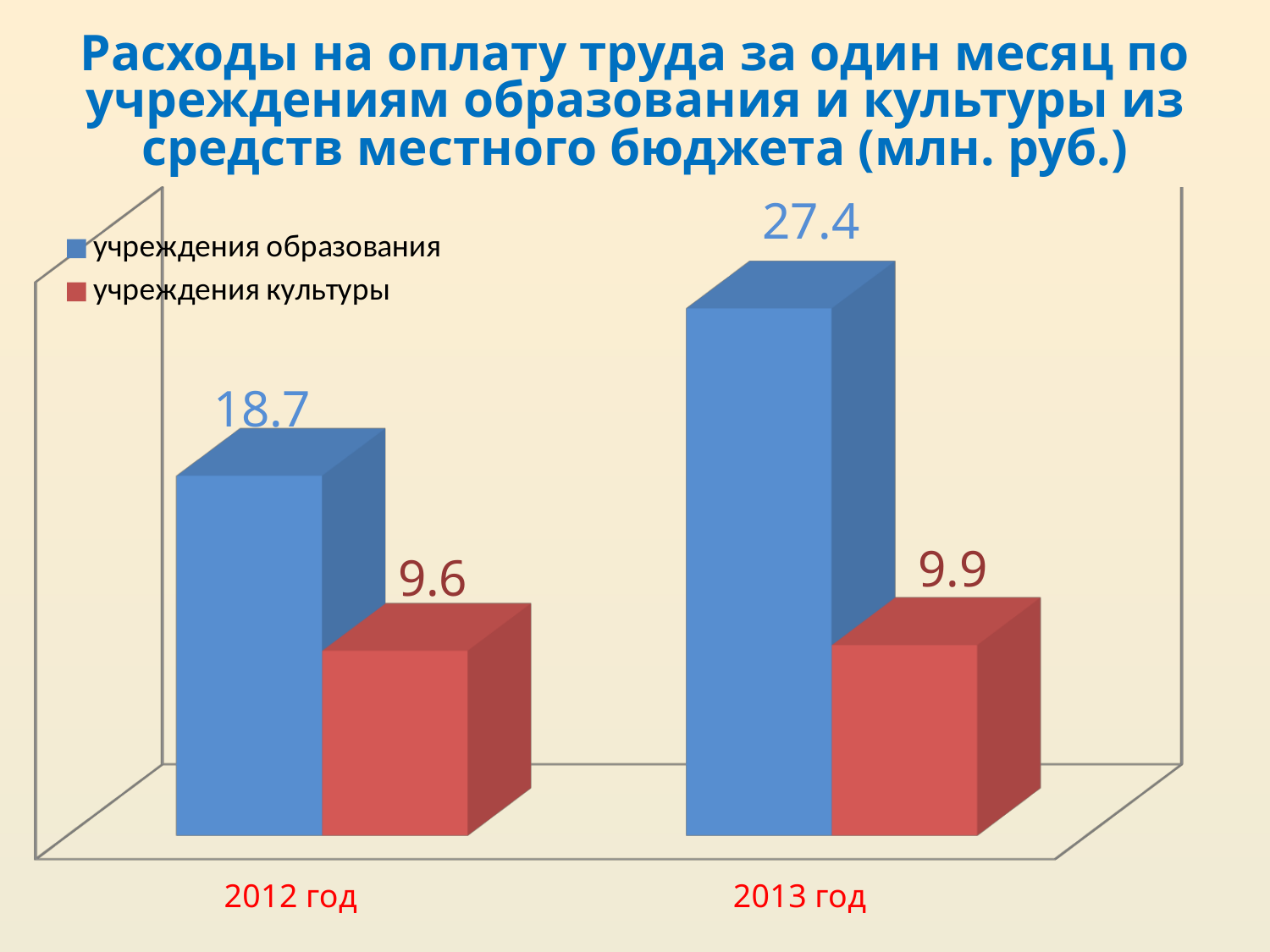
Which year has the highest value for учреждения образования? 2013 год Which is larger in 2012 год: учреждения образования or учреждения культуры? учреждения образования What is the value for учреждения образования in 2013 год? 27.4 What is the value for учреждения культуры in 2012 год? 9.6 What is the difference between учреждения образования and учреждения культуры in 2013 год? 17.5 What is the value for учреждения культуры in 2013 год? 9.9 How many categories are shown on the x axis? 2 What is the value for учреждения образования in 2012 год? 18.7 What is the difference between the учреждения образования values for 2013 год and 2012 год? 8.7 Which year has the lowest value for учреждения культуры? 2012 год How many series does the legend list? 2 What kind of chart is shown on the slide? bar chart